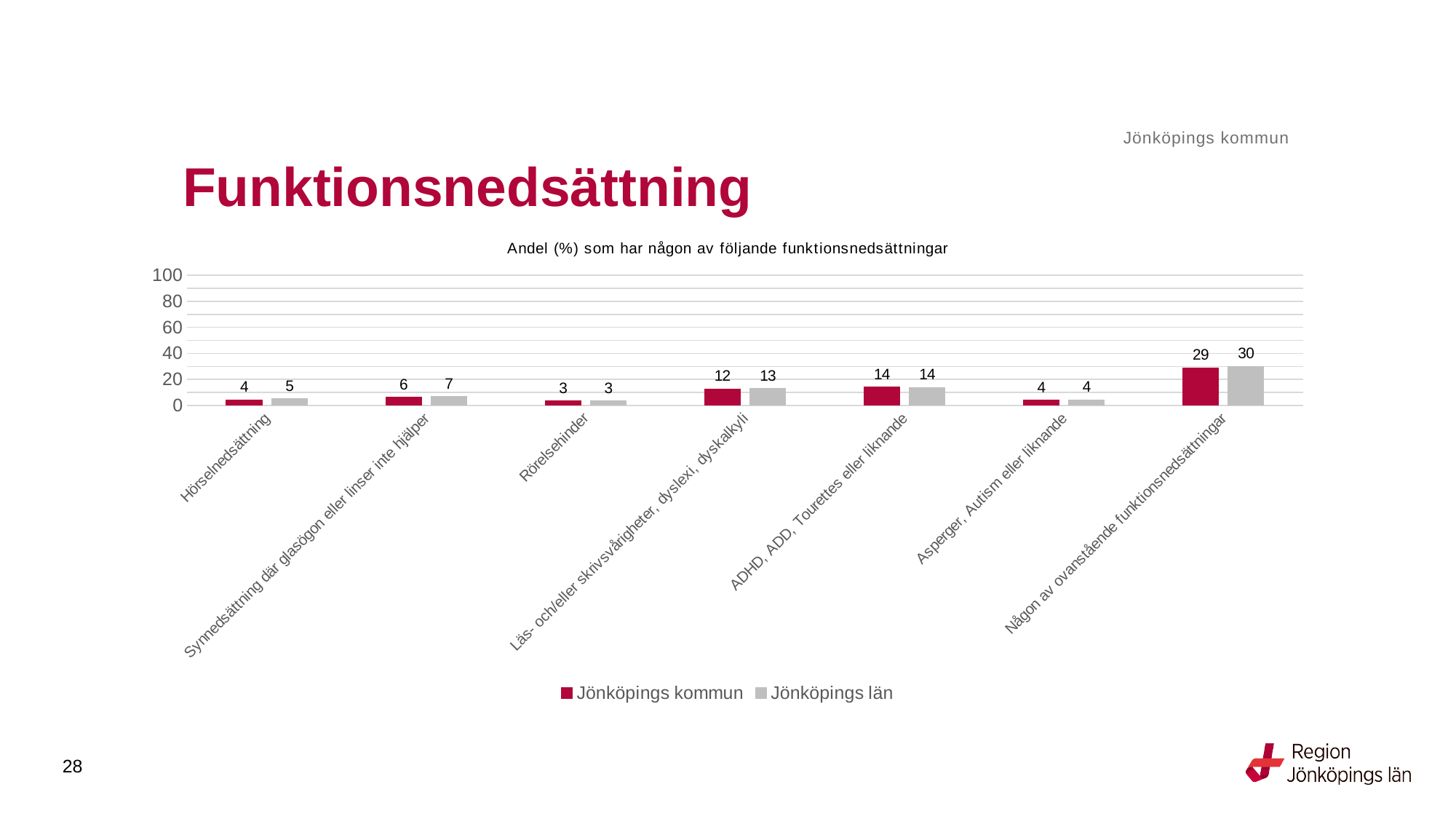
What is the difference between the Jönköpings län and Jönköpings kommun values for Synnedsättning där glasögon eller linser inte hjälper? 1 What is the title of the chart? Andel (%) som har någon av följande funktionsnedsättningar What is the value for Jönköpings kommun for Hörselnedsättning? 4 How many series does the legend list? 2 What is the value for Jönköpings kommun for Någon av ovanstående funktionsnedsättningar? 29 Which is larger for ADHD, ADD, Tourettes eller liknande: Jönköpings kommun or Jönköpings län? They are equal (14) Is the value for Jönköpings län for Någon av ovanstående funktionsnedsättningar greater or less than 20? greater What is the value for Jönköpings län for Läs- och/eller skrivsvårigheter, dyslexi, dyskalkyli? 13 Which category has the highest value for Jönköpings län? Någon av ovanstående funktionsnedsättningar Which category has the lowest value for Jönköpings kommun? Rörelsehinder How many categories are shown on the x axis? 7 What kind of chart is shown on the slide? Bar chart